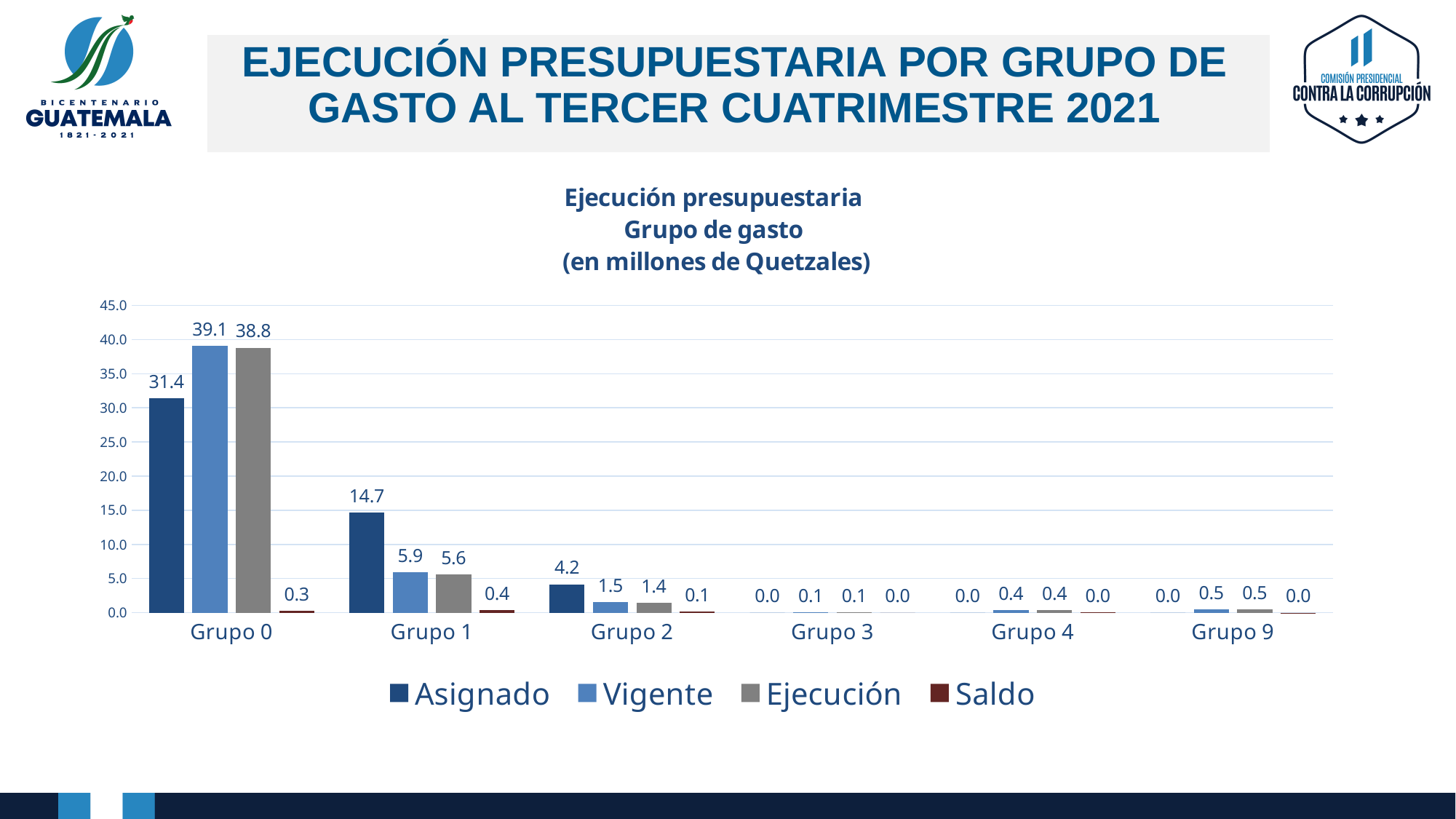
What is the Saldo value for Grupo 1? 0.4 How many groups are shown on the x axis? 6 What unit does the chart title say the values are in? Millones de Quetzales Which group has the lowest Vigente value? Grupo 3 What is the Asignado value for Grupo 1? 14.7 Which is larger for Grupo 1, the Asignado value or the Vigente value? Asignado What kind of chart is shown on the slide? Bar chart How many series does the legend list? 4 What is the Ejecución value for Grupo 2? 1.4 What is the difference between the Vigente and Ejecución values for Grupo 0? 0.3 Which group has the highest Ejecución value? Grupo 0 What is the Vigente value for Grupo 0? 39.1